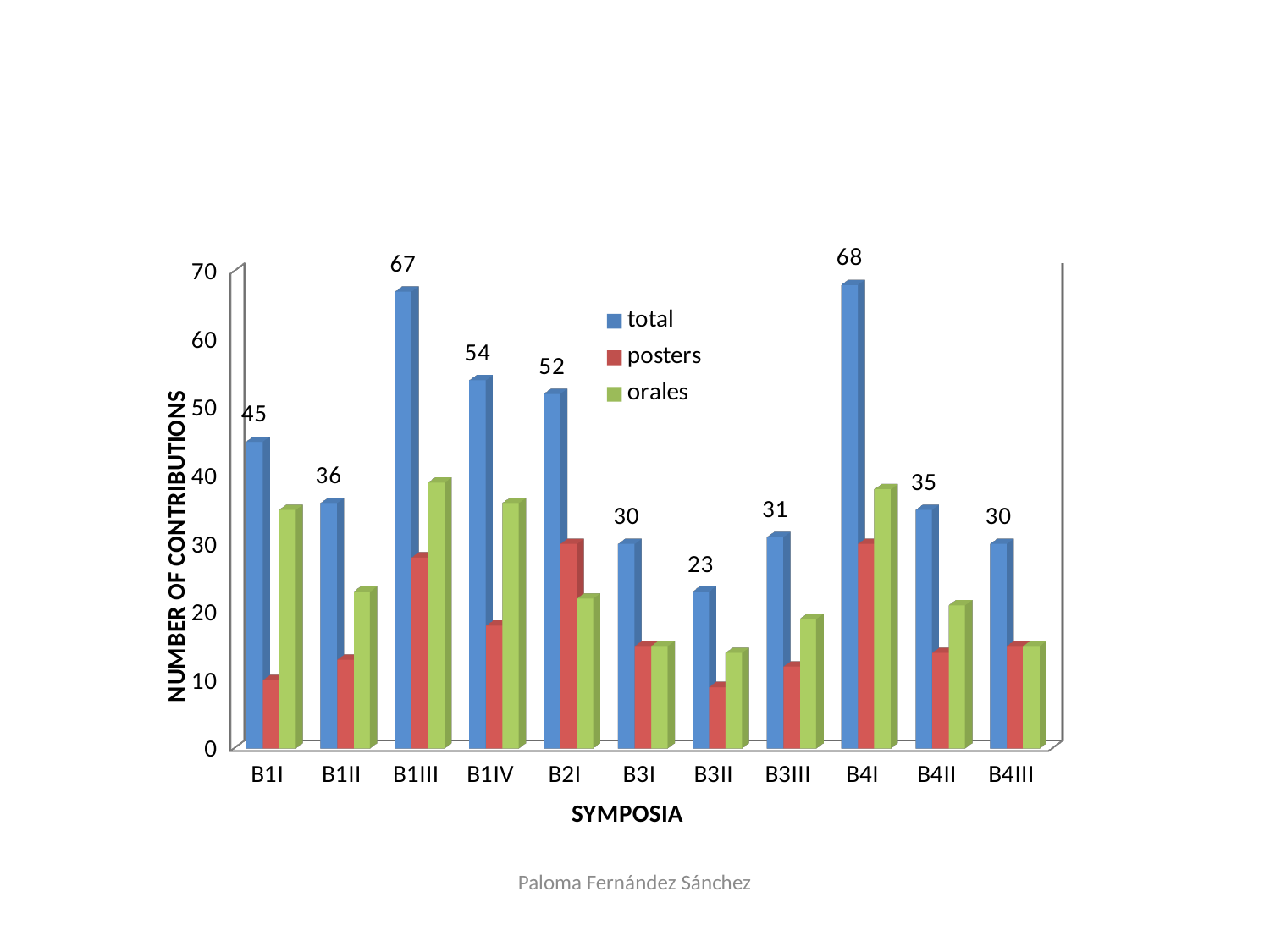
What is the total number of contributions for symposium B4II? 35 Is the value for orales at B1III greater or less than 30? greater Which symposium has the highest total number of contributions? B4I Is the value for posters at B1IV greater or less than 20? less What is the difference between the total contributions for B1IV and B2I? 2 What is the total number of contributions for symposium B3II? 23 How many series does the legend list? 3 What is the total number of contributions for symposium B1III? 67 Which symposium has the lowest total number of contributions? B3II What kind of chart is shown on the slide? Bar chart How many symposia are shown on the x axis? 11 Which has a larger total number of contributions, B1I or B1II? B1I